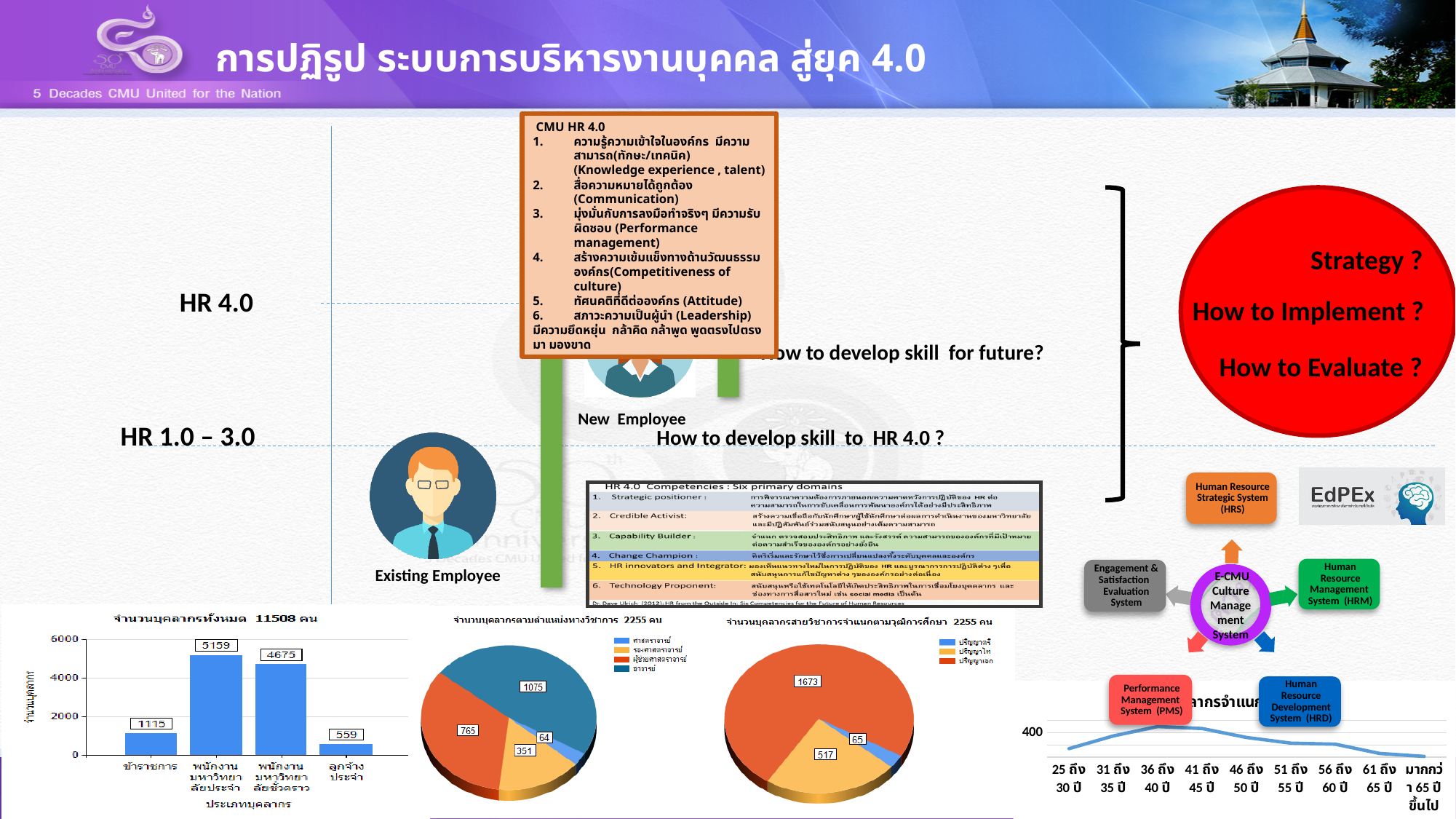
In the bar chart at the bottom left, how many categories are shown on the x axis? 4 In the pie chart titled จำนวนบุคลากรสายวิชาการจำแนกตามวุฒิการศึกษา 2255 คน, what is the difference between the largest slice and the smallest slice? 1608 In the pie chart titled จำนวนบุคลากรสายวิชาการจำแนกตามวุฒิการศึกษา 2255 คน, how many slices are there? 3 In the pie chart titled จำนวนบุคลากรตามตำแหน่งทางวิชาการ 2255 คน, what is the value of the largest slice? 1075 In the pie chart titled จำนวนบุคลากรสายวิชาการจำแนกตามวุฒิการศึกษา 2255 คน, which is larger, the slice labelled 1673 or the slice labelled 517? 1673 In the bar chart at the bottom left, what is the difference between the values for พนักงานมหาวิทยาลัยประจำ and พนักงานมหาวิทยาลัยชั่วคราว? 484 In the pie chart titled จำนวนบุคลากรตามตำแหน่งทางวิชาการ 2255 คน, how many entries does the legend list? 4 In the bar chart at the bottom left (จำนวนบุคลากรทั้งหมด 11508 คน), what is the value for ข้าราชการ? 1115 In the bar chart at the bottom left, which category has the highest value? พนักงานมหาวิทยาลัยประจำ In the pie chart titled จำนวนบุคลากรสายวิชาการจำแนกตามวุฒิการศึกษา 2255 คน, what is the value for ปริญญาโท? 517 In the bar chart at the bottom left, which category has the lowest value? ลูกจ้างประจำ What kind of chart is the chart titled จำนวนบุคลากรทั้งหมด 11508 คน? bar chart